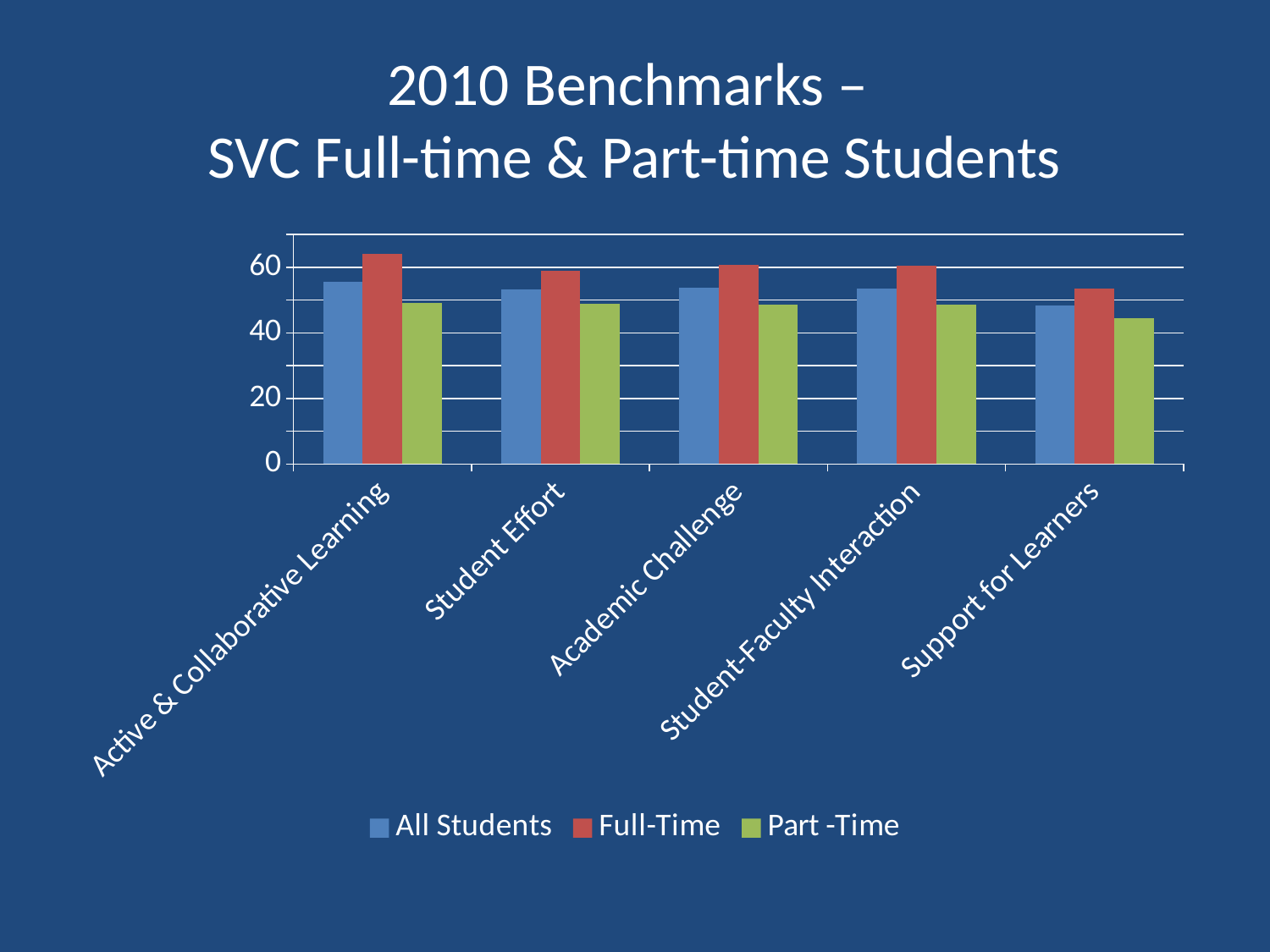
Is the Full-Time value for Support for Learners greater or less than 40? greater What kind of chart is shown on the slide? bar chart Is the Full-Time value for Active & Collaborative Learning greater or less than 60? greater For which category is the Full-Time value highest? Active & Collaborative Learning Is the Part-Time value for Support for Learners greater or less than 60? less How many series does the legend list? 3 For Student Effort, which is larger: the Full-Time value or the Part-Time value? Full-Time How many benchmark categories are shown on the x axis? 5 For Academic Challenge, which is larger: the All Students value or the Full-Time value? Full-Time Which colour represents the Part-Time series in the legend? green For which category is the Part-Time value lowest? Support for Learners